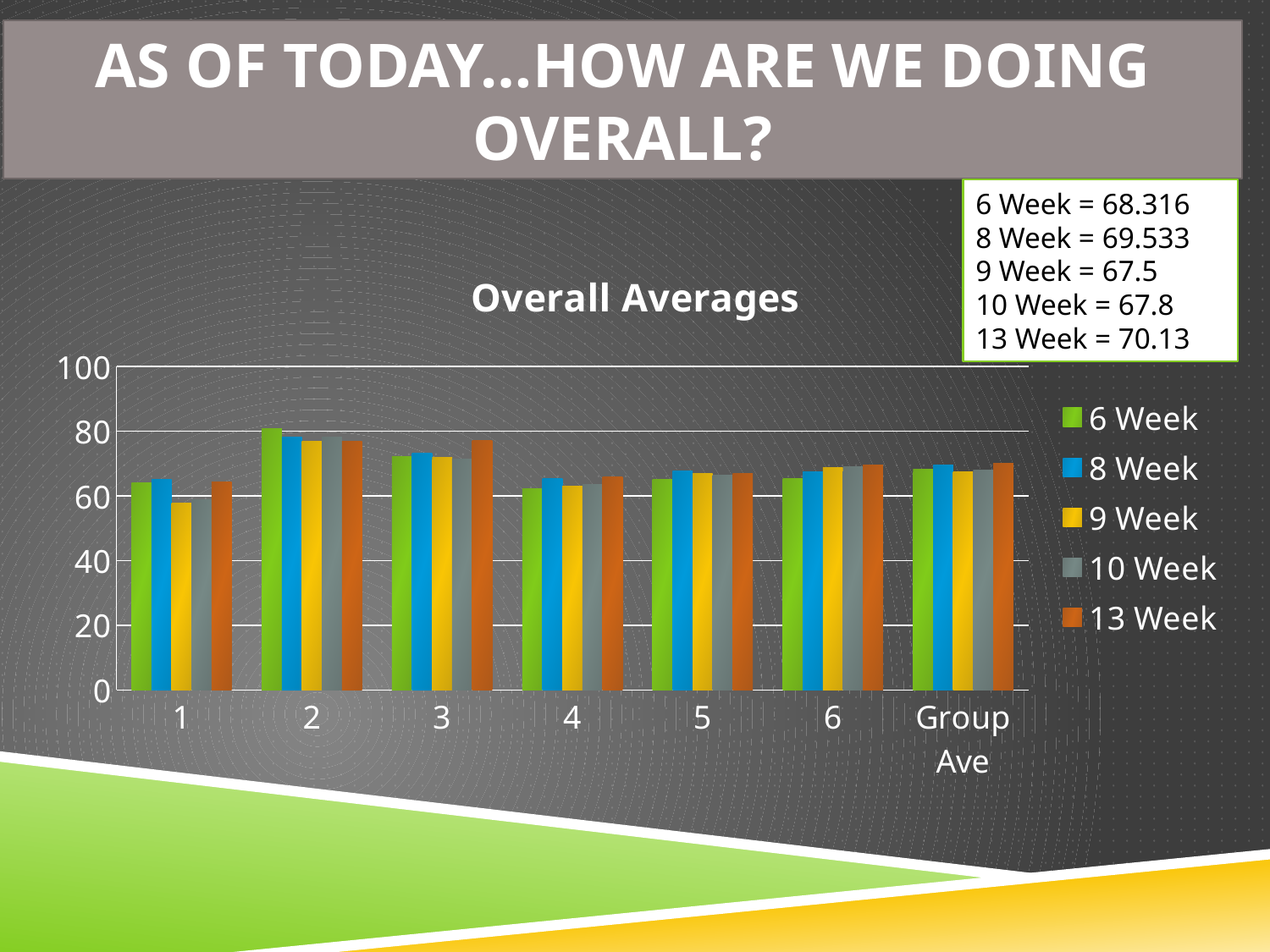
What is the 6 Week Group Ave value? 68.316 How many categories are shown along the x axis of the Overall Averages chart? 7 Which series has the lowest Group Ave value? 9 Week What is the title of the chart? Overall Averages Is the 8 Week Group Ave value larger or smaller than the 10 Week Group Ave value? larger Is the 6 Week value for category 4 greater or less than 80? less For the 6 Week series, which category has the highest value? 2 What kind of chart is shown on the slide? bar chart What is the difference between the 13 Week and 9 Week Group Ave values? 2.63 Which series has the highest Group Ave value? 13 Week What is the 13 Week Group Ave value? 70.13 How many series does the legend of the Overall Averages chart list? 5